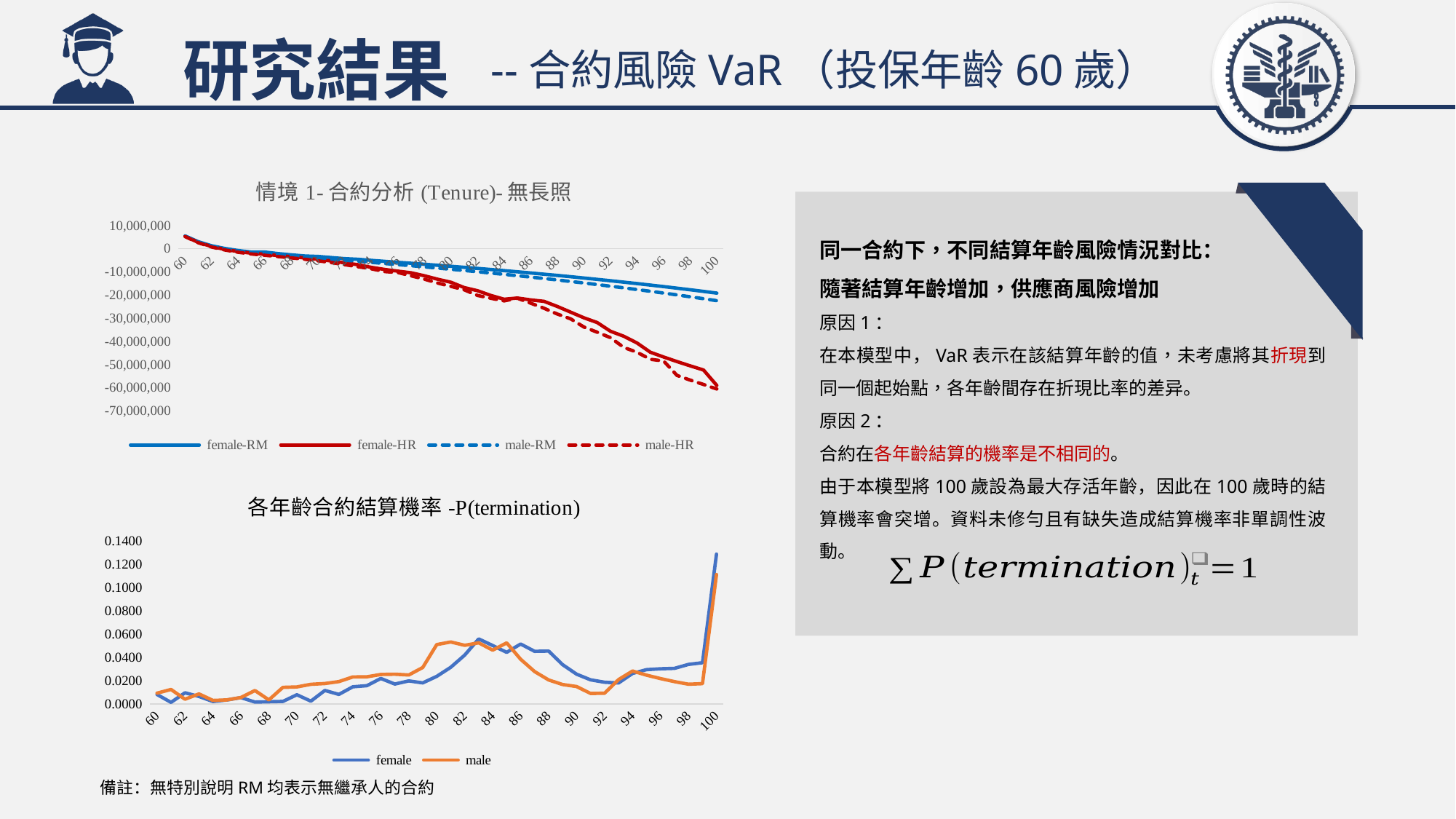
In the top chart (情境 1- 合約分析 (Tenure)- 無長照), at age 100, which series has the larger value, female-RM or female-HR? female-RM What type of chart is the top chart titled 情境 1- 合約分析 (Tenure)- 無長照? line chart In the top chart (情境 1- 合約分析 (Tenure)- 無長照), is the value for female-RM at age 100 greater or less than -30,000,000? greater In the bottom chart (各年齡合約結算機率 -P(termination)), is the value for female at age 100 greater or less than 0.1000? greater How many series does the legend of the bottom chart (各年齡合約結算機率 -P(termination)) list? 2 In the bottom chart (各年齡合約結算機率 -P(termination)), at age 80, which series has the larger value, female or male? male In the bottom chart (各年齡合約結算機率 -P(termination)), at age 100, which series has the larger value, female or male? female How many series does the legend of the top chart (情境 1- 合約分析 (Tenure)- 無長照) list? 4 In the top chart (情境 1- 合約分析 (Tenure)- 無長照), is the value for female-HR at age 100 greater or less than -50,000,000? less What type of chart is the bottom chart titled 各年齡合約結算機率 -P(termination)? line chart In the top chart (情境 1- 合約分析 (Tenure)- 無長照), do the values rise or fall as age increases along the x axis? fall In the top chart (情境 1- 合約分析 (Tenure)- 無長照), which series is drawn as a solid red line? female-HR